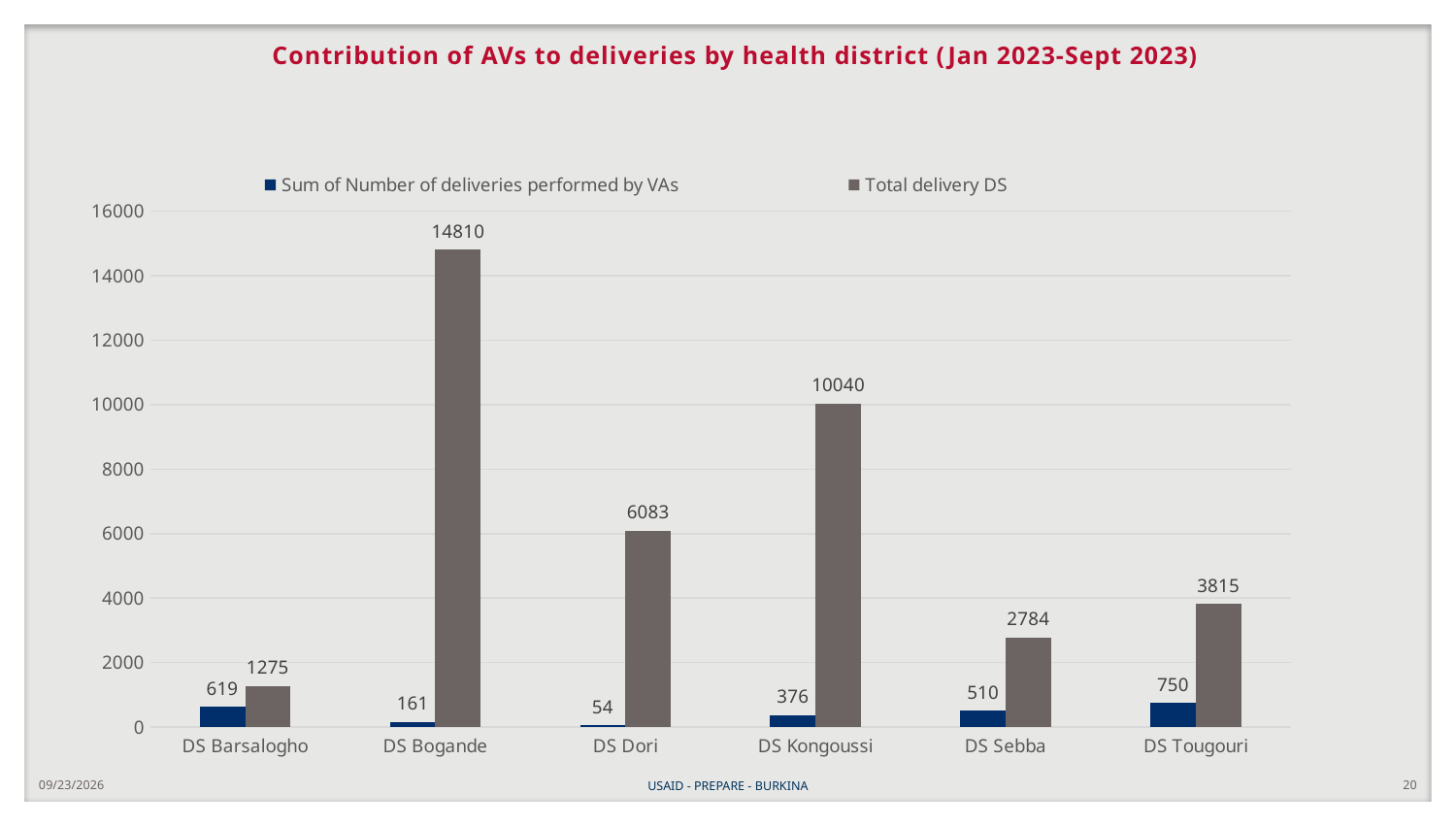
What is the title of the chart? Contribution of AVs to deliveries by health district (Jan 2023-Sept 2023) What is the Total delivery DS value for DS Sebba? 2784 How many series does the legend list? 2 Is the Total delivery DS value for DS Dori greater or less than 8000? less What is the difference between Total delivery DS and deliveries performed by VAs for DS Tougouri? 3065 Which health district has the lowest Sum of Number of deliveries performed by VAs? DS Dori What is the Sum of Number of deliveries performed by VAs for DS Dori? 54 What kind of chart is shown on the slide? bar chart How many health districts are shown on the x axis? 6 Which is larger: the deliveries performed by VAs in DS Barsalogho or in DS Kongoussi? DS Barsalogho Which health district has the highest Total delivery DS? DS Bogande What is the Total delivery DS value for DS Bogande? 14810